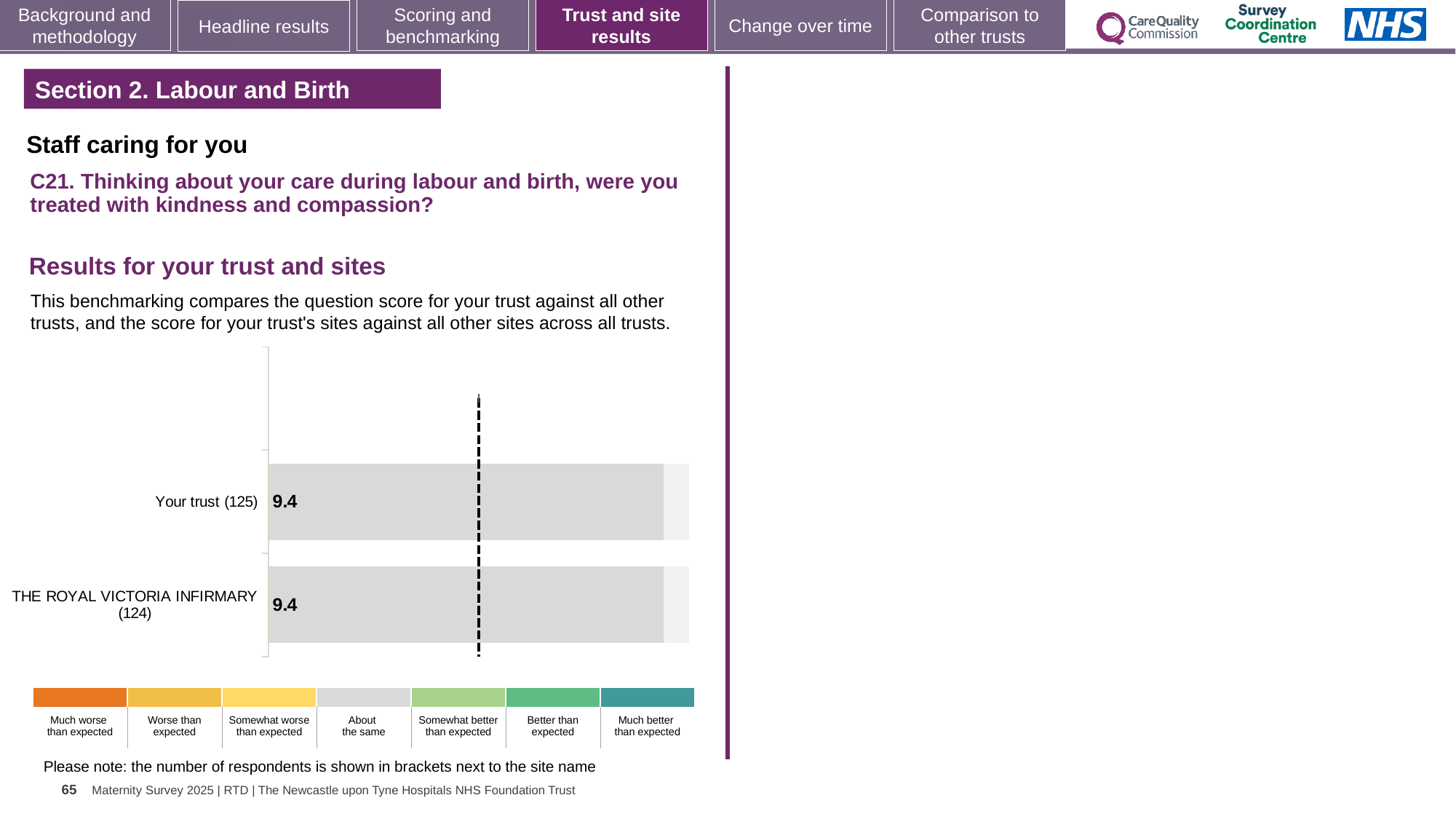
Which benchmarking category does the grey colour of the bars correspond to in the key? About the same How many respondents are shown in brackets for THE ROYAL VICTORIA INFIRMARY? 124 What is the score for Your trust (125) on the chart? 9.4 How many respondents are shown in brackets for Your trust? 125 How many bars are plotted on the chart? 2 How many benchmarking categories does the colour key below the chart list? 7 Which survey question does the chart on the slide relate to? C21. Thinking about your care during labour and birth, were you treated with kindness and compassion? What is the score for THE ROYAL VICTORIA INFIRMARY (124) on the chart? 9.4 What is the difference between the score for Your trust and the score for THE ROYAL VICTORIA INFIRMARY? 0 What kind of chart is shown on the slide? Bar chart